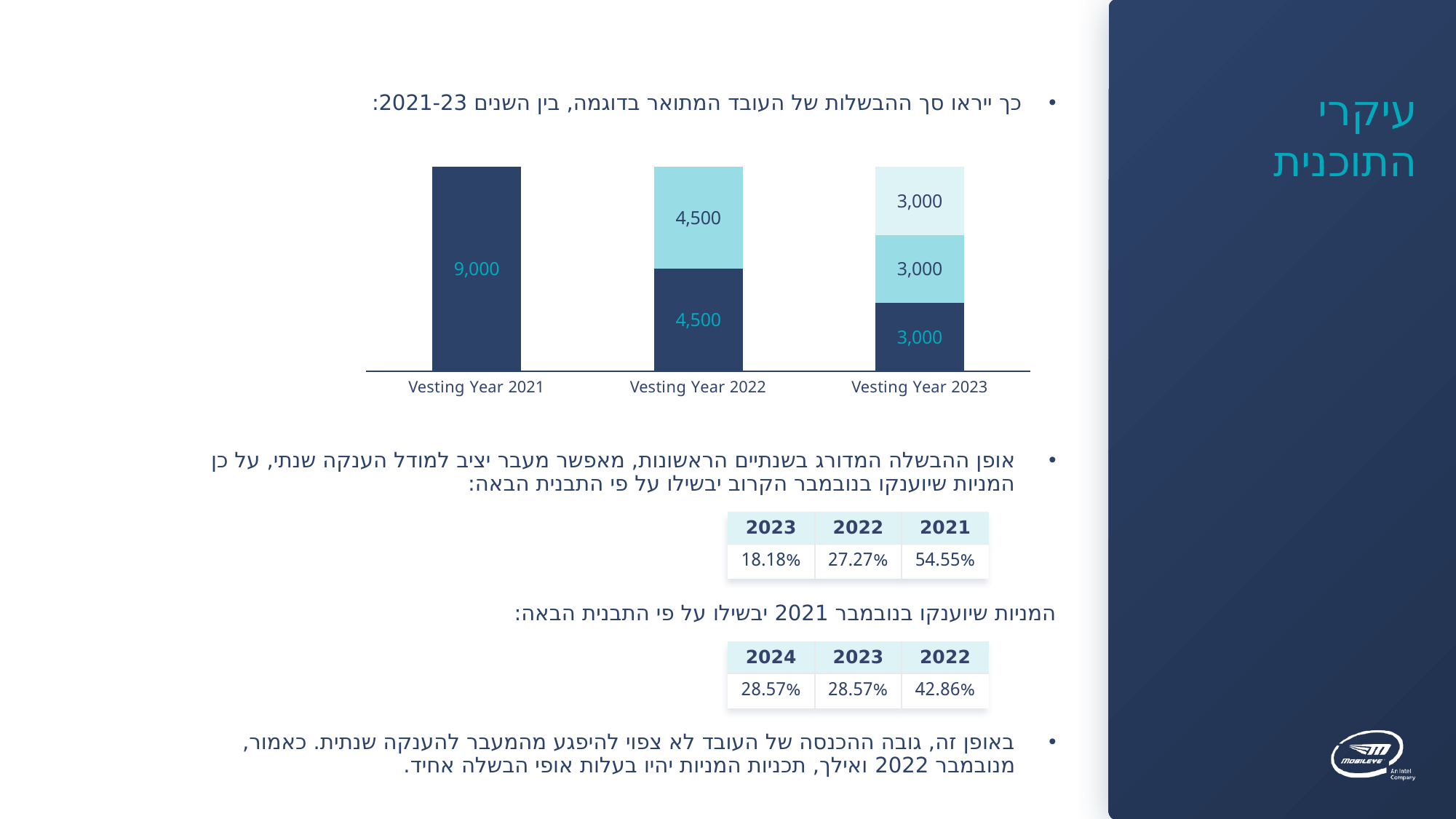
What is the label of the first category on the x axis of the chart? Vesting Year 2021 What is the value of the bottom segment for Vesting Year 2022? 4,500 What is the total of the stacked bar for Vesting Year 2023? 9,000 Which is larger: the bottom segment of Vesting Year 2021 or the bottom segment of Vesting Year 2022? Vesting Year 2021 What is the difference between the bottom segment of Vesting Year 2022 and the bottom segment of Vesting Year 2023? 1,500 What is the total of the stacked bar for Vesting Year 2022? 9,000 What kind of chart is shown on the slide? stacked bar chart How many categories are shown on the x axis of the chart? 3 What is the difference between the single segment of Vesting Year 2021 and the top segment of Vesting Year 2022? 4,500 What is the value of the single segment for Vesting Year 2021? 9,000 What is the value of the top segment for Vesting Year 2023? 3,000 How many segments make up the bar for Vesting Year 2023? 3